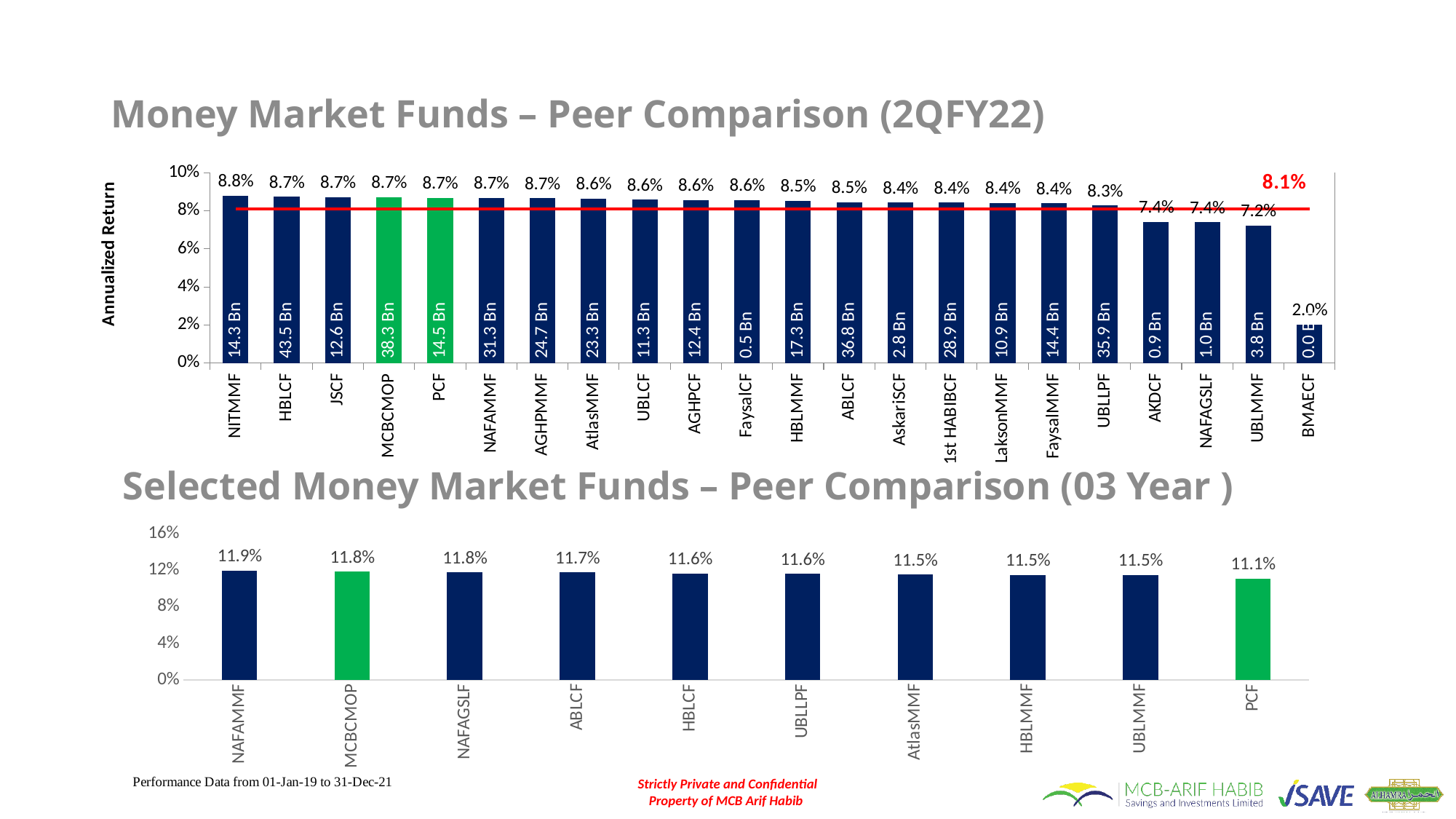
In the bottom chart (Selected Money Market Funds – Peer Comparison 03 Year), what is the return for NAFAMMF? 11.9% How many funds are shown in the bottom chart? 10 In the top chart, what is the difference between the annualized returns of NITMMF and BMAECF? 6.8% In the top chart, what fund size is shown inside the MCBCMOP bar? 38.3 Bn In the top chart, what is the annualized return for MCBCMOP? 8.7% In the top chart, is the annualized return for UBLMMF greater or less than 8%? less In the top chart, which fund has the lowest annualized return? BMAECF In the top chart, which fund has the highest annualized return? NITMMF In the top chart, what value is marked by the red horizontal line? 8.1% In the bottom chart, which fund has the lowest return? PCF What type of chart is the bottom chart? Bar chart In the top chart (Money Market Funds – Peer Comparison 2QFY22), what is the annualized return for NITMMF? 8.8%